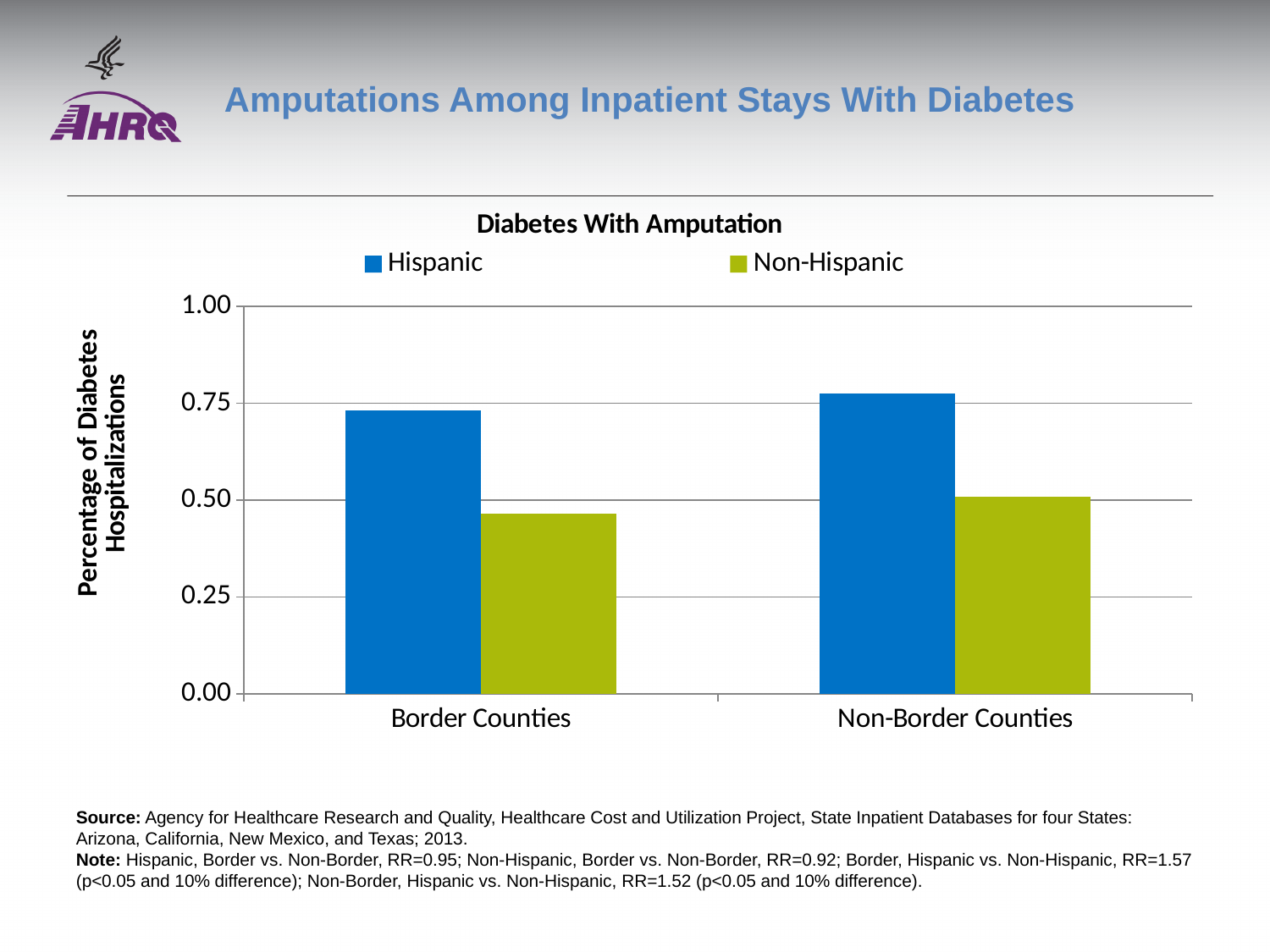
Is the Hispanic value for Border Counties greater or less than 0.50? greater In Border Counties, which group has the higher value, Hispanic or Non-Hispanic? Hispanic What type of chart is shown on the slide? bar chart Is the Non-Hispanic value for Border Counties greater or less than 0.50? less Which bar is the highest in the chart? Hispanic, Non-Border Counties How many series does the legend list? 2 What is the y-axis label of the chart? Percentage of Diabetes Hospitalizations How many categories are shown on the x axis? 2 What is the title of the chart? Diabetes With Amputation Which bar is the lowest in the chart? Non-Hispanic, Border Counties Is the Non-Hispanic value for Non-Border Counties greater or less than 0.75? less